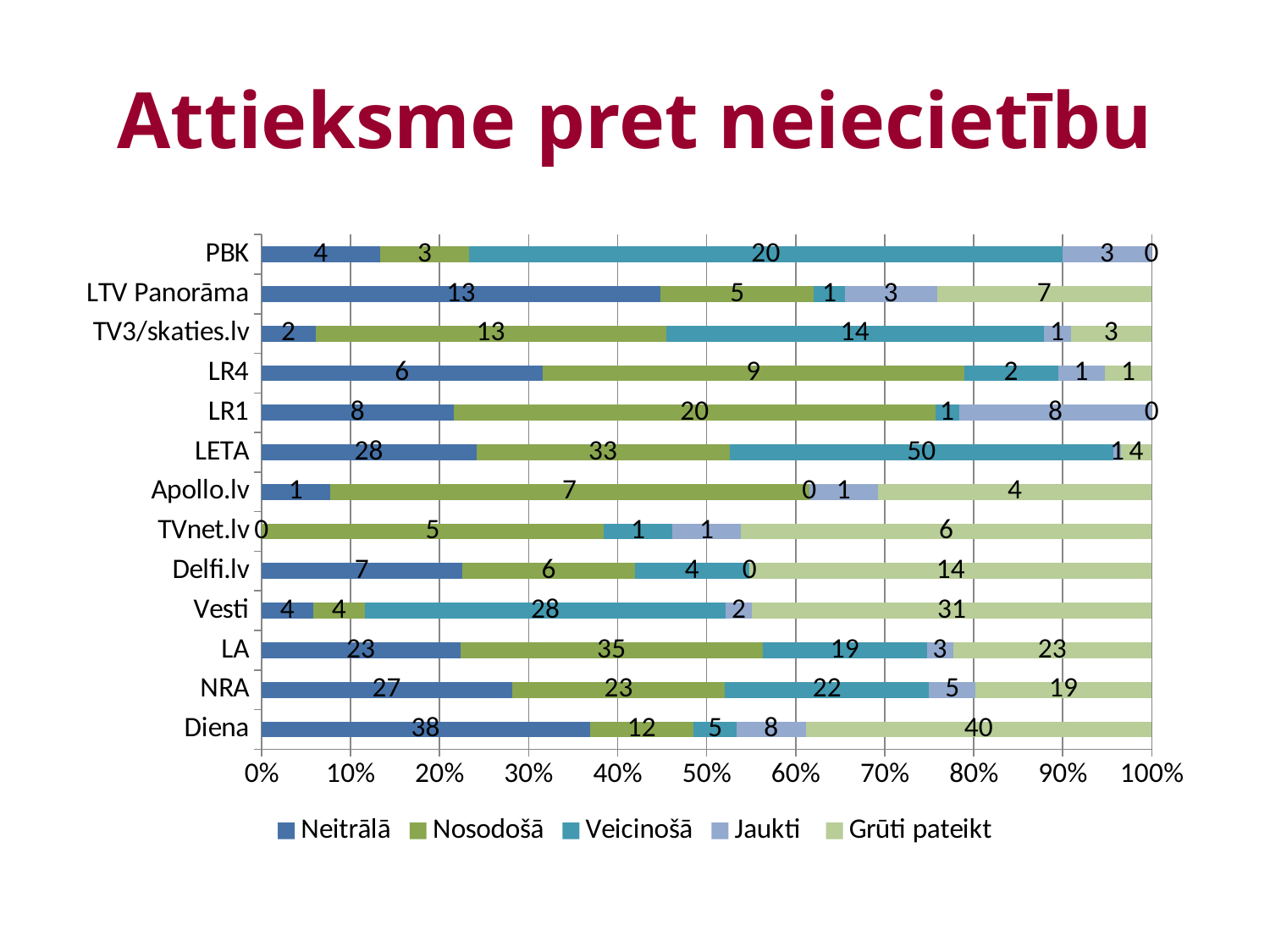
Which is larger, the Veicinošā value for Vesti or for NRA? Vesti What is the Neitrālā value for Diena? 38 What is the total of all values in the Diena bar? 103 What is the difference between the Nosodošā values for LA and NRA? 12 Which category has the highest Neitrālā value? Diena What is the Veicinošā value for LETA? 50 How many categories are shown on the y axis? 13 What is the Jaukti value for LR1? 8 What is the Grūti pateikt value for Vesti? 31 Which category has the highest Nosodošā value? LA What kind of chart is shown on the slide? Stacked bar chart How many series does the legend list? 5